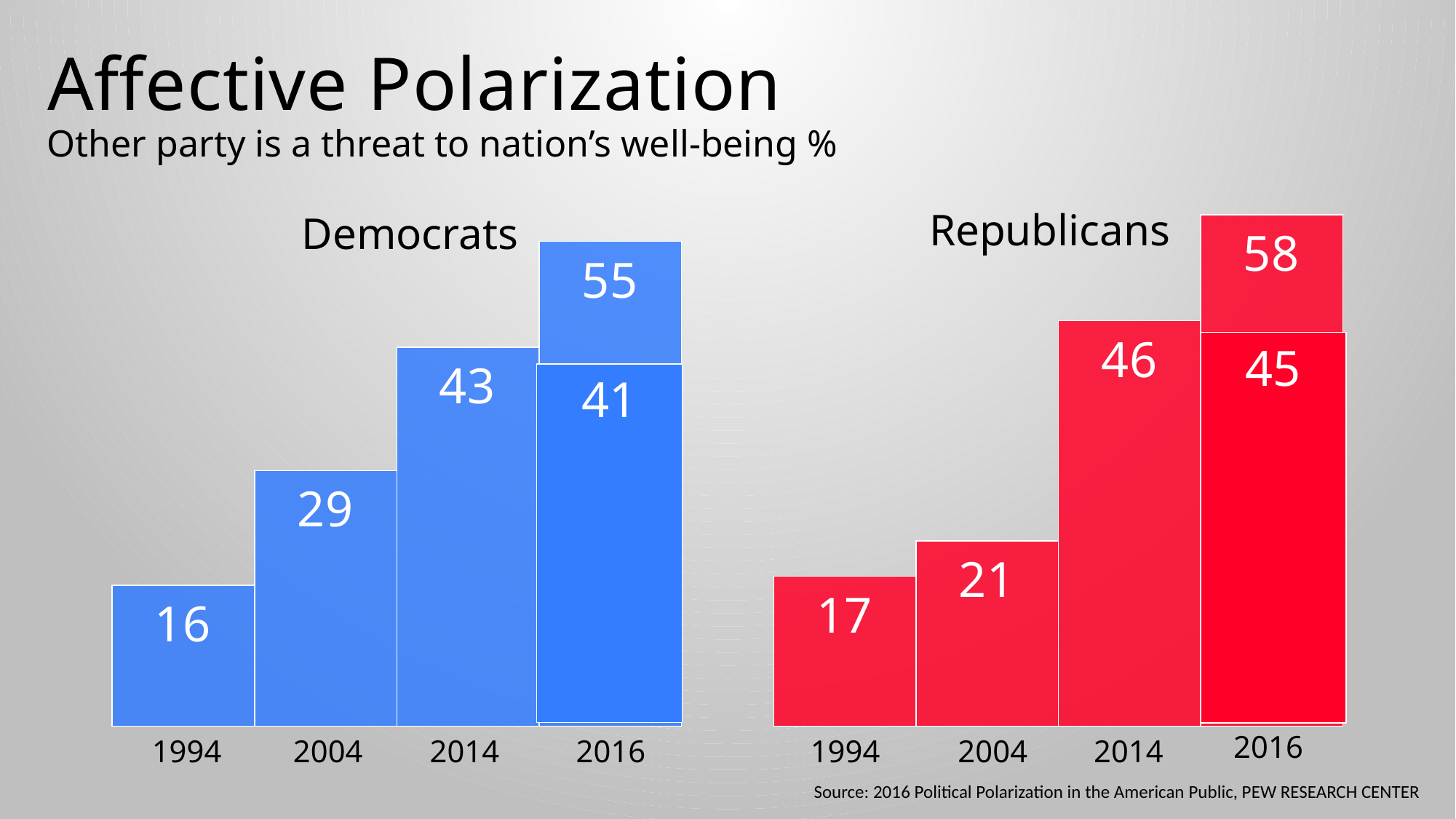
Which is larger: the 2004 value on the Democrats chart or the 2004 value on the Republicans chart? Democrats On the Republicans chart, what is the value for 2014? 46 On the Democrats chart, what is the value for 1994? 16 On the Democrats chart, which year has the lowest value? 1994 On the Republicans chart, what is the largest value printed? 58 How many years are labeled on the x axis of the Democrats chart? 4 On the Republicans chart, what is the difference between the 2014 value and the 1994 value? 29 On the Republicans chart, do the values rise or fall from 1994 to 2014? Rise On the Democrats chart, what is the difference between the 2014 value and the 2004 value? 14 On the Republicans chart, what is the value for 2004? 21 On the Democrats chart, what is the value for 2014? 43 What kind of chart is used for the Republicans data? Bar chart